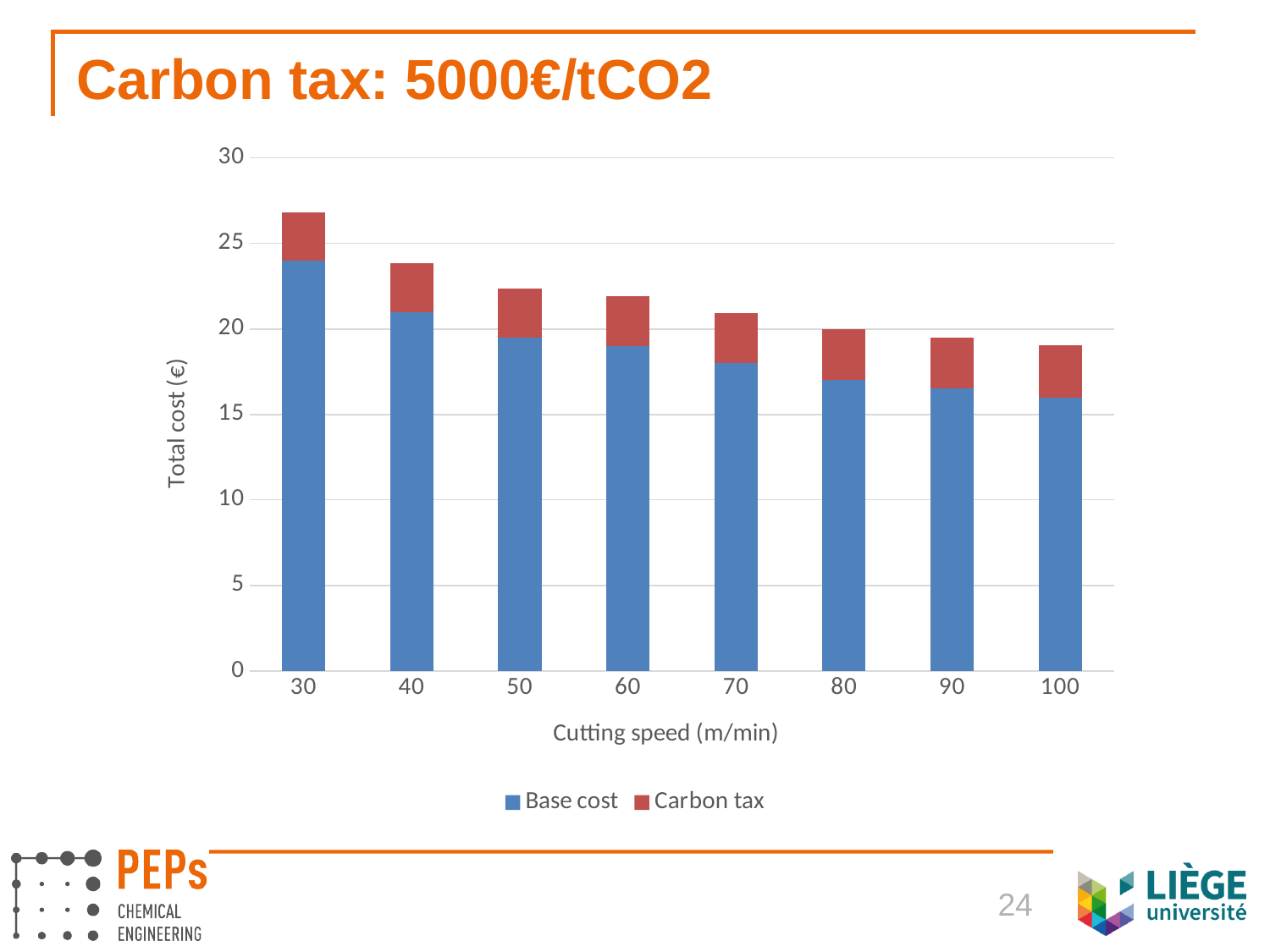
What is the label of the y axis? Total cost (€) Is the base cost at a cutting speed of 80 m/min greater or less than 20? less Does the total cost rise or fall as cutting speed increases? Fall Is the total cost at a cutting speed of 30 m/min greater or less than 25? greater How many series does the legend list? 2 Which has the larger base cost: a cutting speed of 40 m/min or 70 m/min? 40 Is the total cost at a cutting speed of 100 m/min greater or less than 20? less At which cutting speed is the total cost highest? 30 How many cutting speed categories are shown on the x axis? 8 What kind of chart is shown on the slide? Stacked bar chart At which cutting speed is the total cost lowest? 100